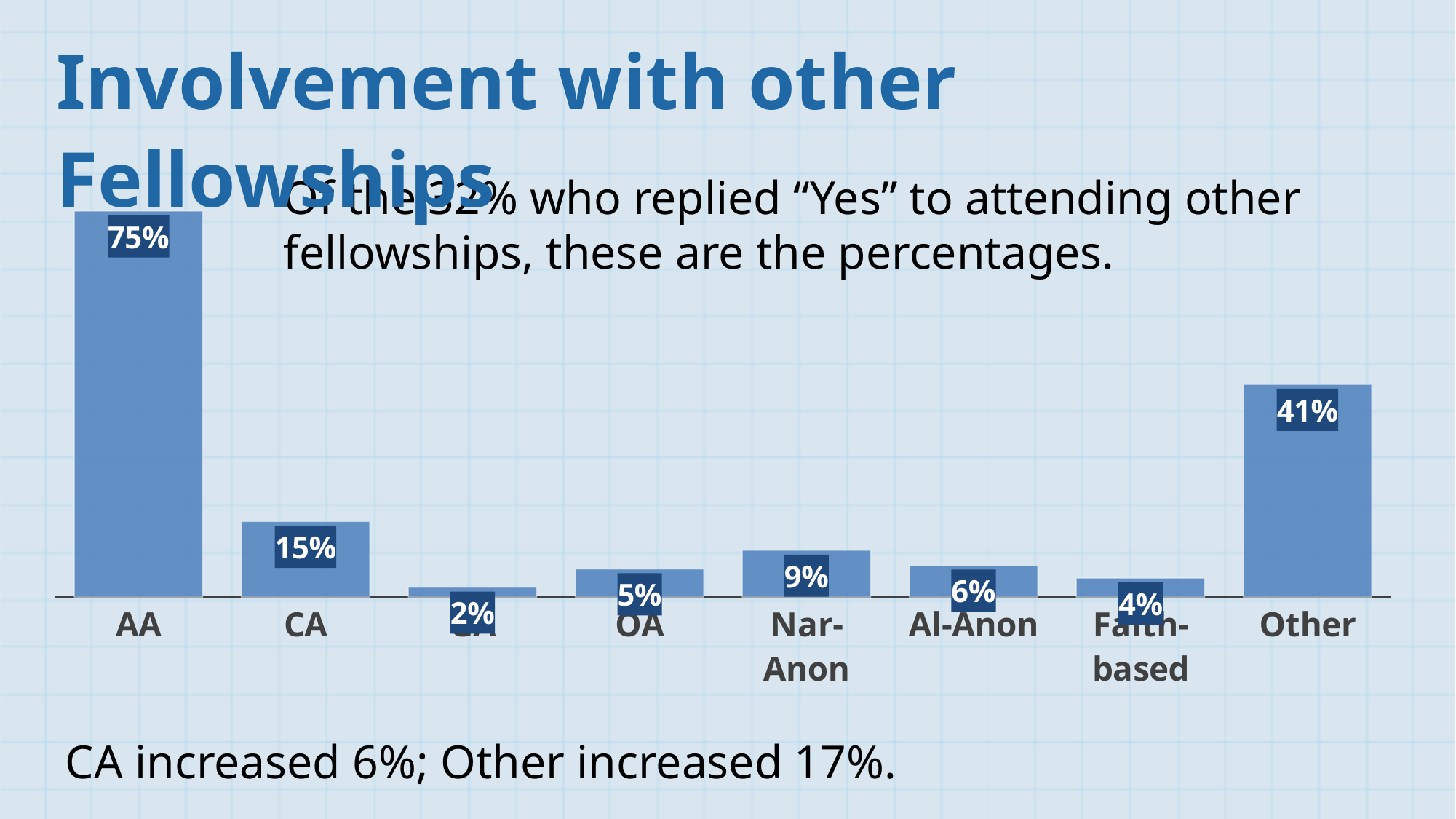
Which fellowship has the highest percentage? AA What percentage is shown for Other? 41% What percentage is shown for AA? 75% How many fellowship categories are shown on the chart? 8 Which has a larger percentage, CA or Nar-Anon? CA According to the note at the bottom of the slide, by how much did Other increase? 17% What is the difference between the percentages for CA and OA? 10% Which has a larger percentage, Al-Anon or OA? Al-Anon What is the difference between the percentages for AA and Other? 34% What kind of chart is shown on the slide? Bar chart What percentage is shown for Nar-Anon? 9% What percentage is shown for Faith-based? 4%